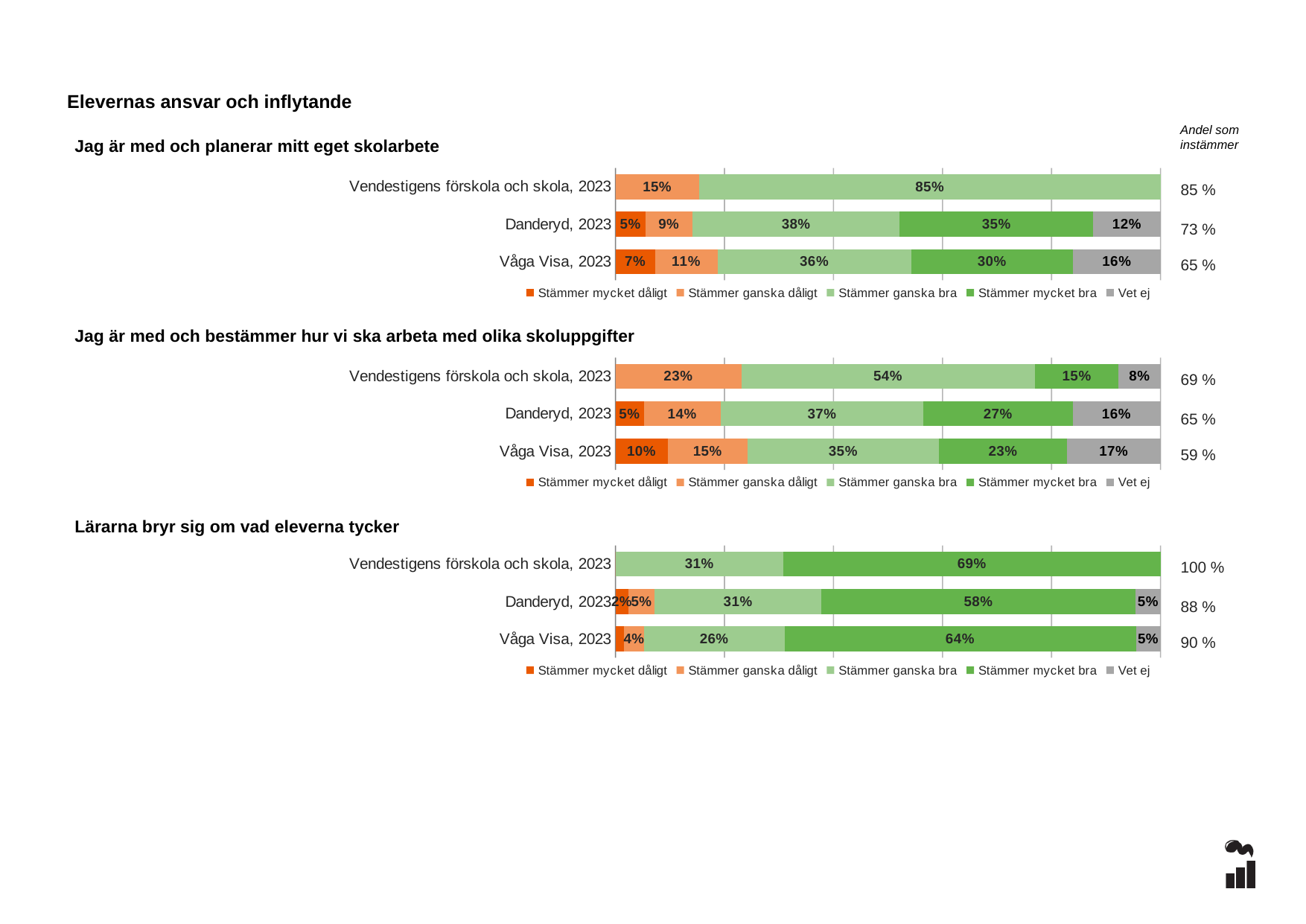
In the chart 'Lärarna bryr sig om vad eleverna tycker', is the 'Stämmer mycket bra' value larger for Danderyd, 2023 or Våga Visa, 2023? Våga Visa, 2023 In the chart 'Jag är med och planerar mitt eget skolarbete', what is the 'Vet ej' value for Våga Visa, 2023? 16% How many categories (bars) are shown in the chart 'Lärarna bryr sig om vad eleverna tycker'? 3 In the chart 'Lärarna bryr sig om vad eleverna tycker', what is the 'Andel som instämmer' shown for Danderyd, 2023? 88 % In the chart 'Jag är med och bestämmer hur vi ska arbeta med olika skoluppgifter', what is the difference between the 'Stämmer ganska bra' values for Vendestigens förskola och skola, 2023 and Danderyd, 2023? 17 percentage points In the chart 'Jag är med och planerar mitt eget skolarbete', which category has the highest 'Stämmer mycket bra' value? Danderyd, 2023 In the chart 'Jag är med och planerar mitt eget skolarbete', what is the 'Stämmer ganska bra' value for Vendestigens förskola och skola, 2023? 85% In the chart 'Jag är med och bestämmer hur vi ska arbeta med olika skoluppgifter', which category has the lowest 'Stämmer mycket bra' value? Vendestigens förskola och skola, 2023 In the chart 'Lärarna bryr sig om vad eleverna tycker', what is the 'Stämmer mycket bra' value for Vendestigens förskola och skola, 2023? 69% In the chart 'Jag är med och bestämmer hur vi ska arbeta med olika skoluppgifter', what is the 'Stämmer mycket dåligt' value for Våga Visa, 2023? 10% What kind of chart is 'Jag är med och bestämmer hur vi ska arbeta med olika skoluppgifter'? Stacked bar chart How many series does the legend list in the chart 'Jag är med och planerar mitt eget skolarbete'? 5